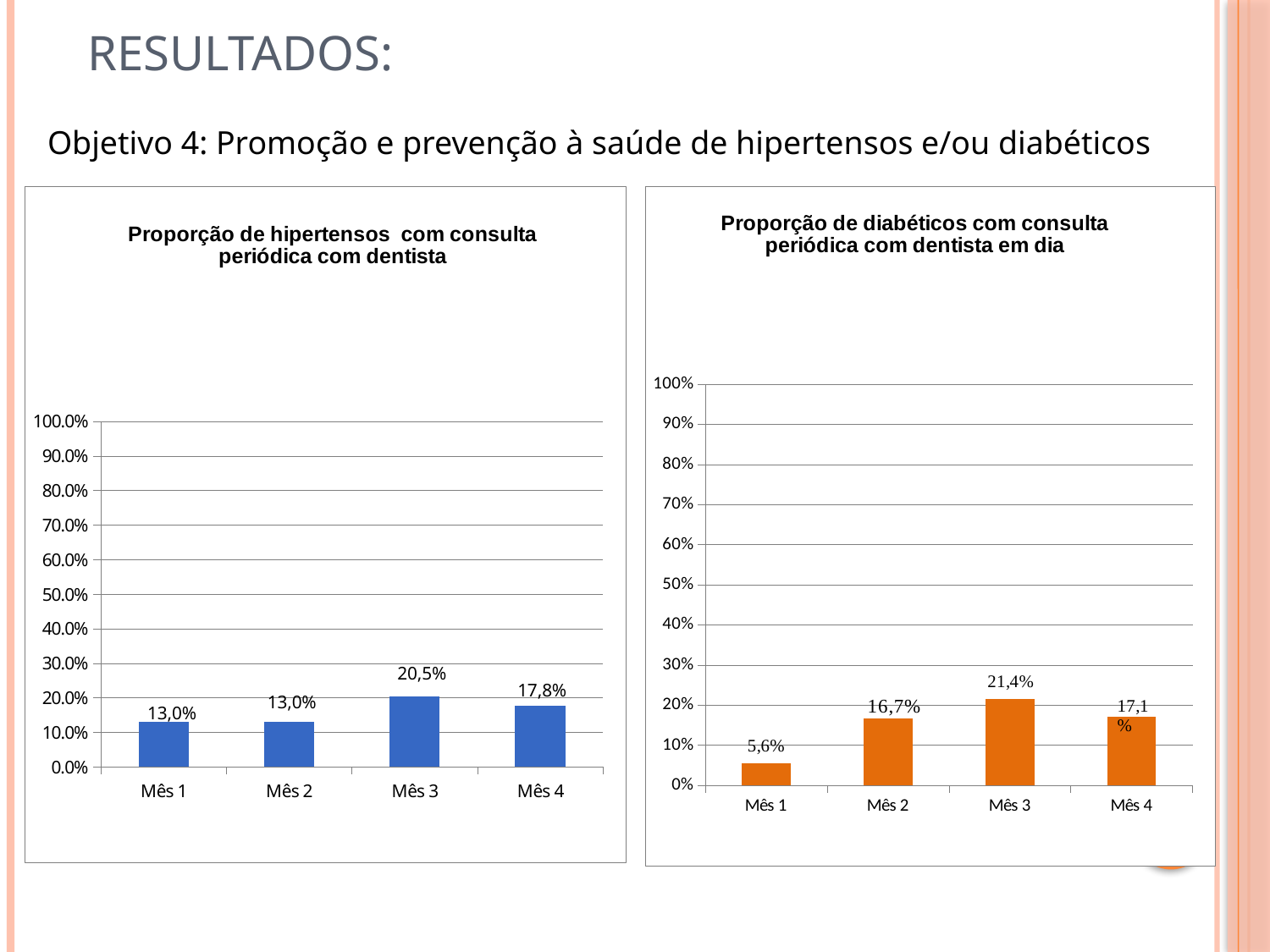
In the chart 'Proporção de diabéticos com consulta periódica com dentista em dia', which month has the lowest value? Mês 1 In the chart 'Proporção de hipertensos com consulta periódica com dentista', what is the difference between the values for Mês 3 and Mês 4? 2,7 percentage points In the chart 'Proporção de diabéticos com consulta periódica com dentista em dia', what is the value for Mês 2? 16,7% What kind of chart is the chart on the right of the slide? Bar chart In the chart 'Proporção de diabéticos com consulta periódica com dentista em dia', what is the value for Mês 1? 5,6% In the chart 'Proporção de hipertensos com consulta periódica com dentista', what is the value for Mês 4? 17,8% In the chart 'Proporção de diabéticos com consulta periódica com dentista em dia', which month has the highest value? Mês 3 In the chart 'Proporção de hipertensos com consulta periódica com dentista', what is the value for Mês 3? 20,5% In the chart 'Proporção de hipertensos com consulta periódica com dentista', how many months are shown on the x axis? 4 In the chart 'Proporção de diabéticos com consulta periódica com dentista em dia', what is the difference between the values for Mês 3 and Mês 1? 15,8 percentage points In the chart 'Proporção de hipertensos com consulta periódica com dentista', which month has the highest value? Mês 3 In the chart 'Proporção de diabéticos com consulta periódica com dentista em dia', is the value for Mês 3 greater or less than 20%? greater